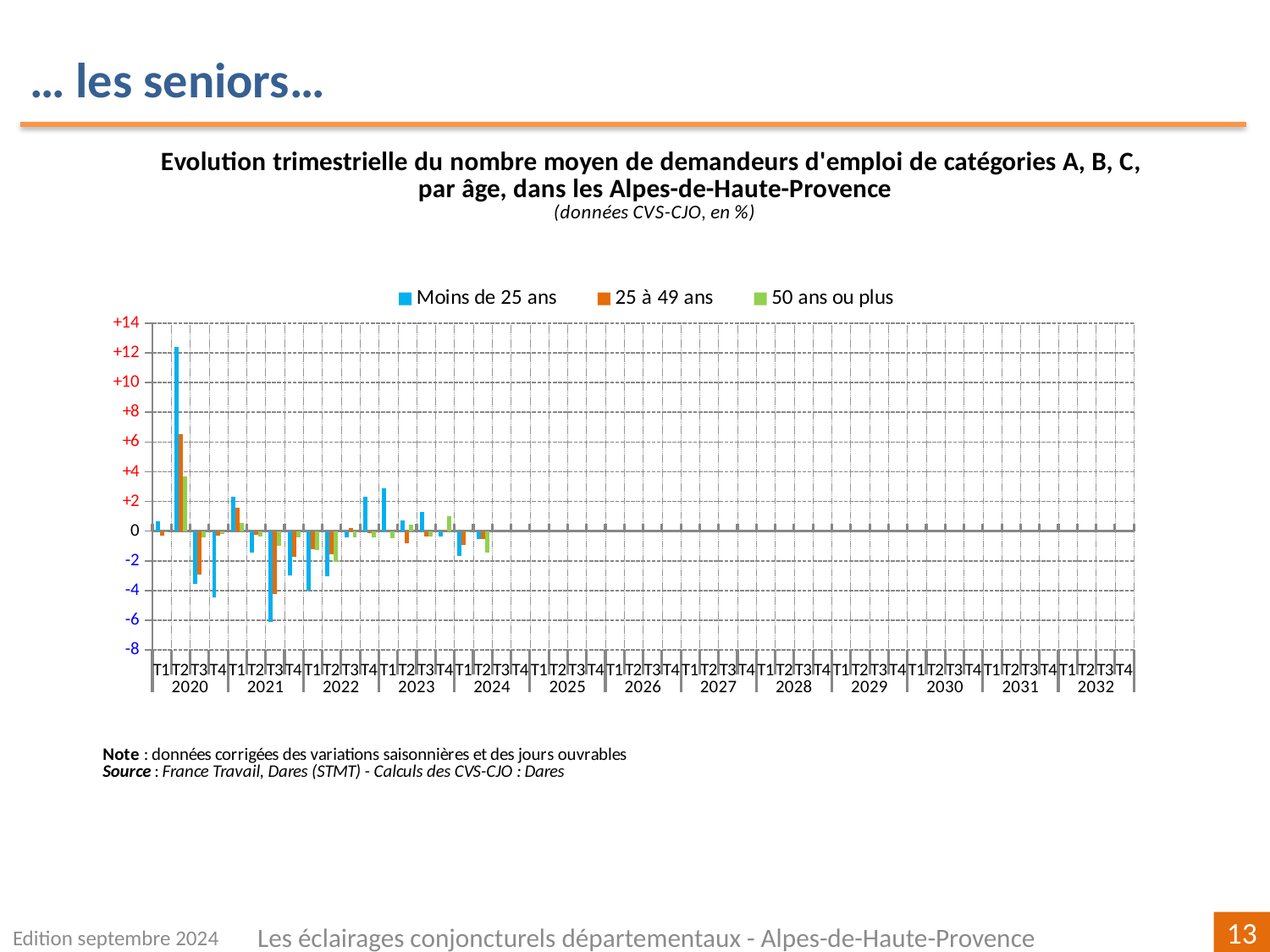
What kind of chart is shown on the slide? bar chart Which department is named in the chart title? Alpes-de-Haute-Provence Is the value for 50 ans ou plus in T2 2020 greater or less than +2? greater How many years are labelled along the x axis? 13 In which quarter does the Moins de 25 ans series reach its highest value? T2 2020 Is the value for 25 à 49 ans in T2 2020 greater or less than +4? greater How many series does the legend list? 3 What are the three series named in the legend? Moins de 25 ans, 25 à 49 ans, 50 ans ou plus Is the value for Moins de 25 ans in T2 2020 greater or less than +10? greater In T2 2020, which series has the larger value: Moins de 25 ans or 25 à 49 ans? Moins de 25 ans In which quarter does the Moins de 25 ans series reach its lowest value? T3 2021